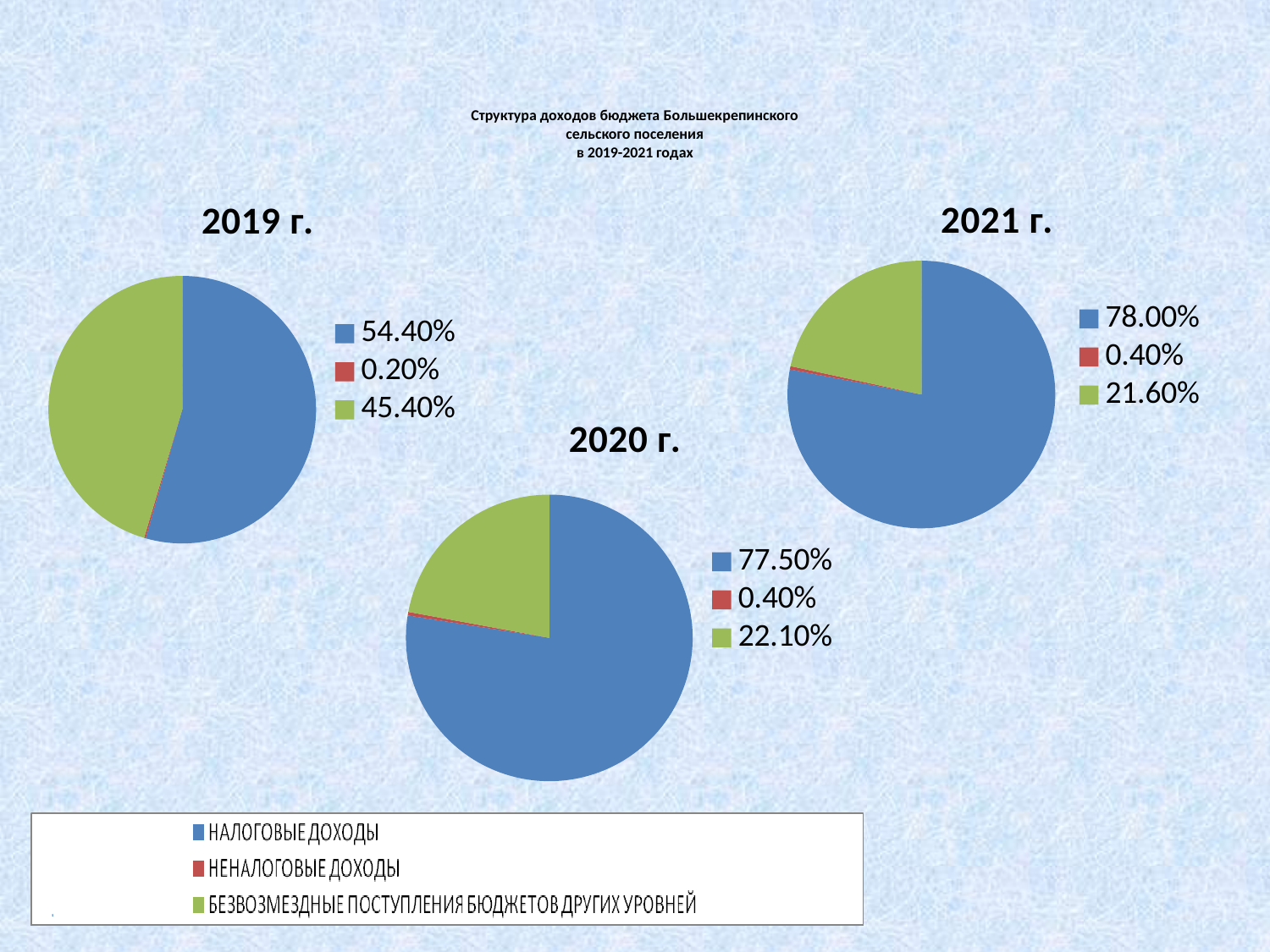
Which colour represents НЕНАЛОГОВЫЕ ДОХОДЫ in the legend? Red In the 2021 г. pie chart, which category has the smallest share? НЕНАЛОГОВЫЕ ДОХОДЫ How many categories does the legend at the bottom of the slide list? 3 In the 2019 г. pie chart, what share is shown for БЕЗВОЗМЕЗДНЫЕ ПОСТУПЛЕНИЯ БЮДЖЕТОВ ДРУГИХ УРОВНЕЙ (green slice)? 45.40% Which is larger: the green slice in the 2020 г. pie chart or the green slice in the 2021 г. pie chart? 2020 г. (22.10%) What type of chart is used on this slide to show the budget revenue structure? Pie chart In the 2019 г. pie chart, what share is shown for НАЛОГОВЫЕ ДОХОДЫ (blue slice)? 54.40% What is the difference between the НАЛОГОВЫЕ ДОХОДЫ share in 2021 г. and in 2019 г.? 23.60% In the 2020 г. pie chart, which category has the largest share? НАЛОГОВЫЕ ДОХОДЫ How many pie charts are shown on the slide? 3 In the 2020 г. pie chart, what share is shown for НЕНАЛОГОВЫЕ ДОХОДЫ (red slice)? 0.40% In the 2021 г. pie chart, what share is shown for НАЛОГОВЫЕ ДОХОДЫ (blue slice)? 78.00%